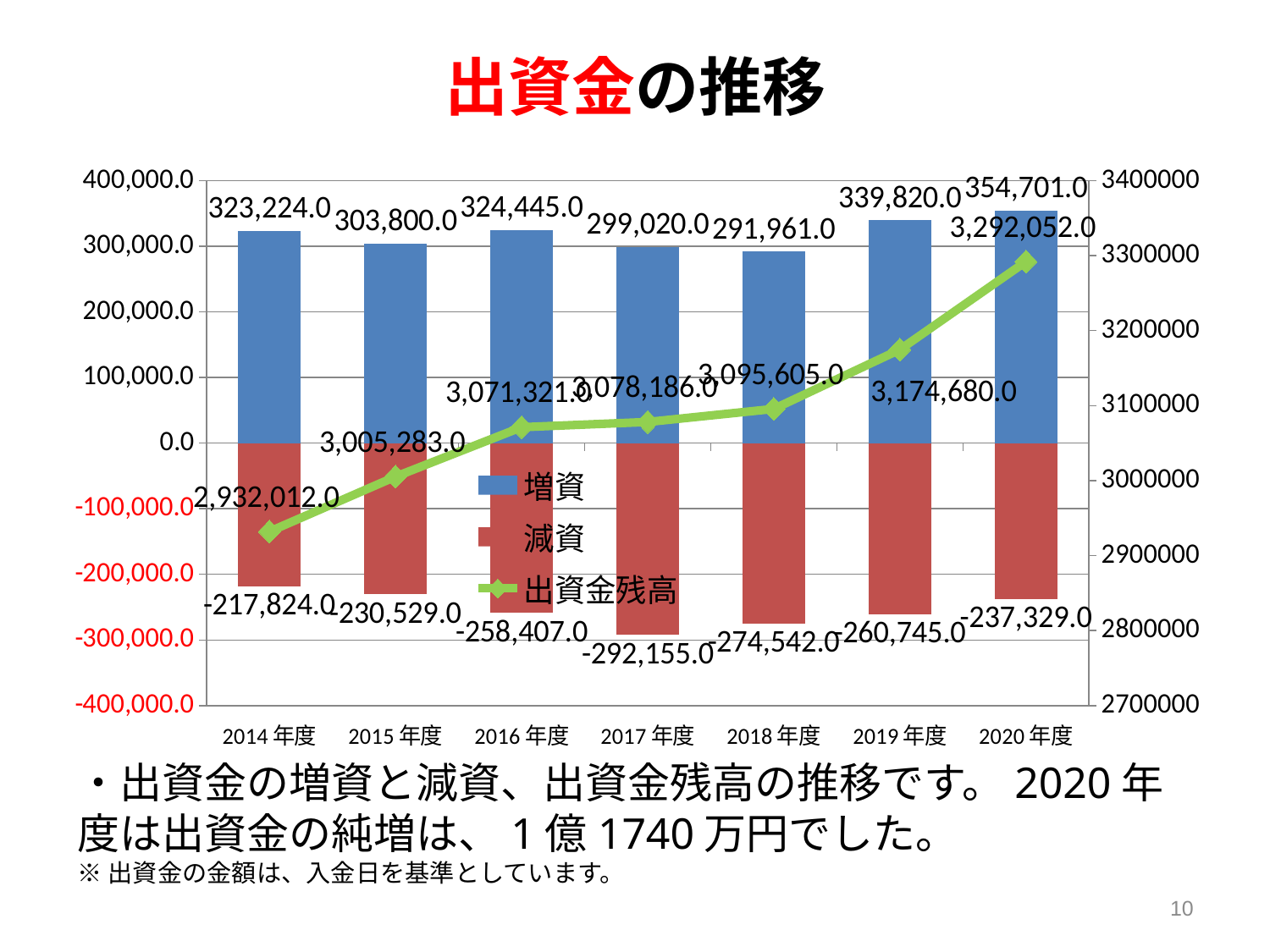
How many series does the legend list? 3 What kind of chart is this? Combined bar and line chart By how much did 出資金残高 increase from 2014年度 to 2020年度? 360,040.0 What is the value of 増資 for 2020年度? 354,701.0 Which year has the highest 増資 value? 2020年度 What is the value of 減資 for 2017年度? -292,155.0 Which is larger, the 増資 value for 2015年度 or for 2016年度? 2016年度 Which year has the lowest 増資 value? 2018年度 How many years (categories) are shown on the x axis? 7 What is the 出資金残高 value for 2014年度? 2,932,012.0 What is the difference between the 増資 values for 2020年度 and 2019年度? 14,881.0 Does the 出資金残高 line rise or fall from 2014年度 to 2020年度? Rise